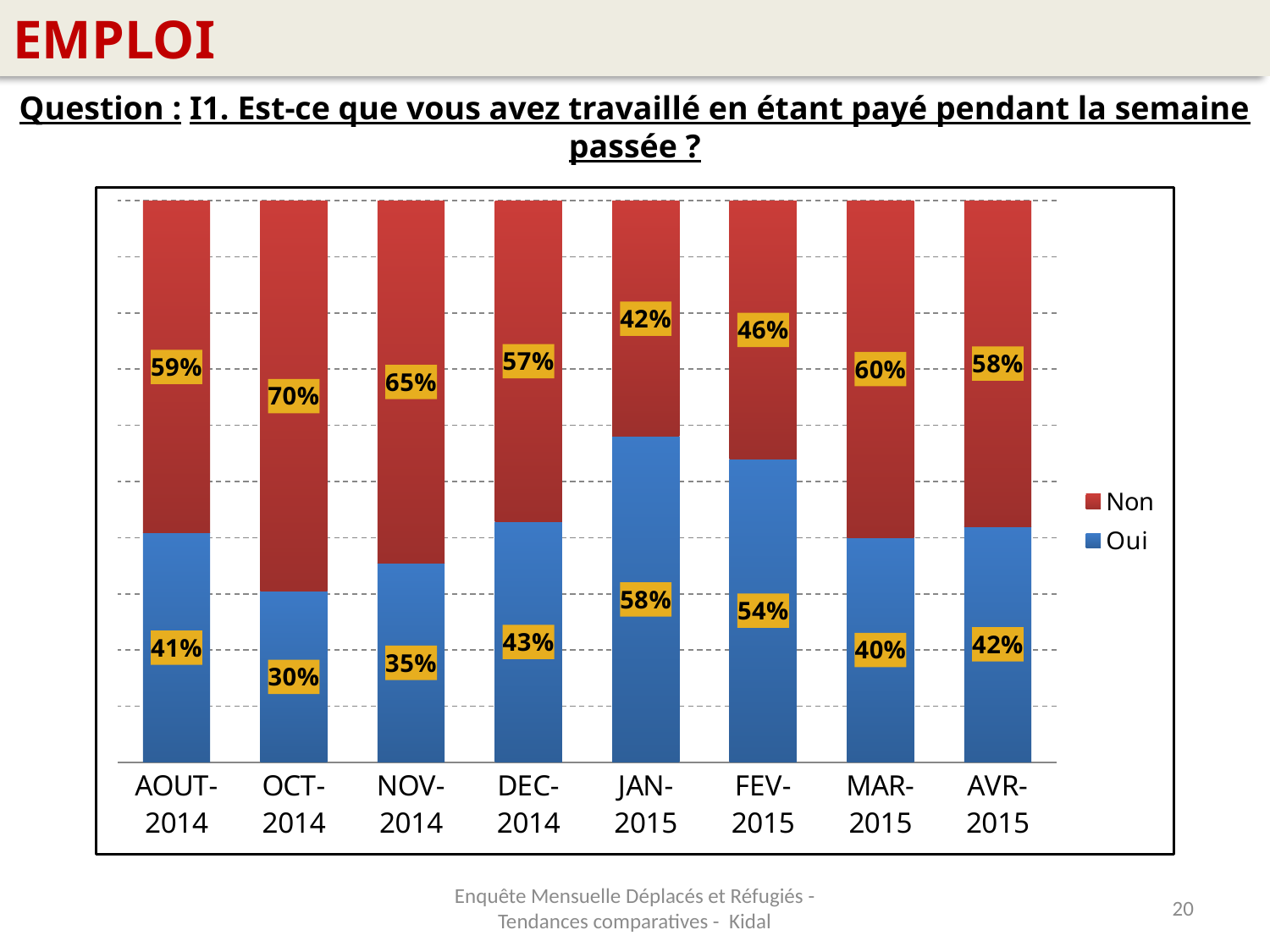
What is the difference between the Oui values for JAN-2015 and OCT-2014? 28% What is the value for Oui in JAN-2015? 58% What is the value for Non in AVR-2015? 58% What is the value for Non in OCT-2014? 70% In which month is the Oui share lowest? OCT-2014 In which month is the Oui share highest? JAN-2015 How many series does the legend list? 2 How many months are shown on the x axis? 8 Which is larger, the Oui value for FEV-2015 or the Oui value for MAR-2015? FEV-2015 What kind of chart is shown on the slide? Stacked bar chart What is the value for Oui in NOV-2014? 35% In which month is the Non share highest? OCT-2014